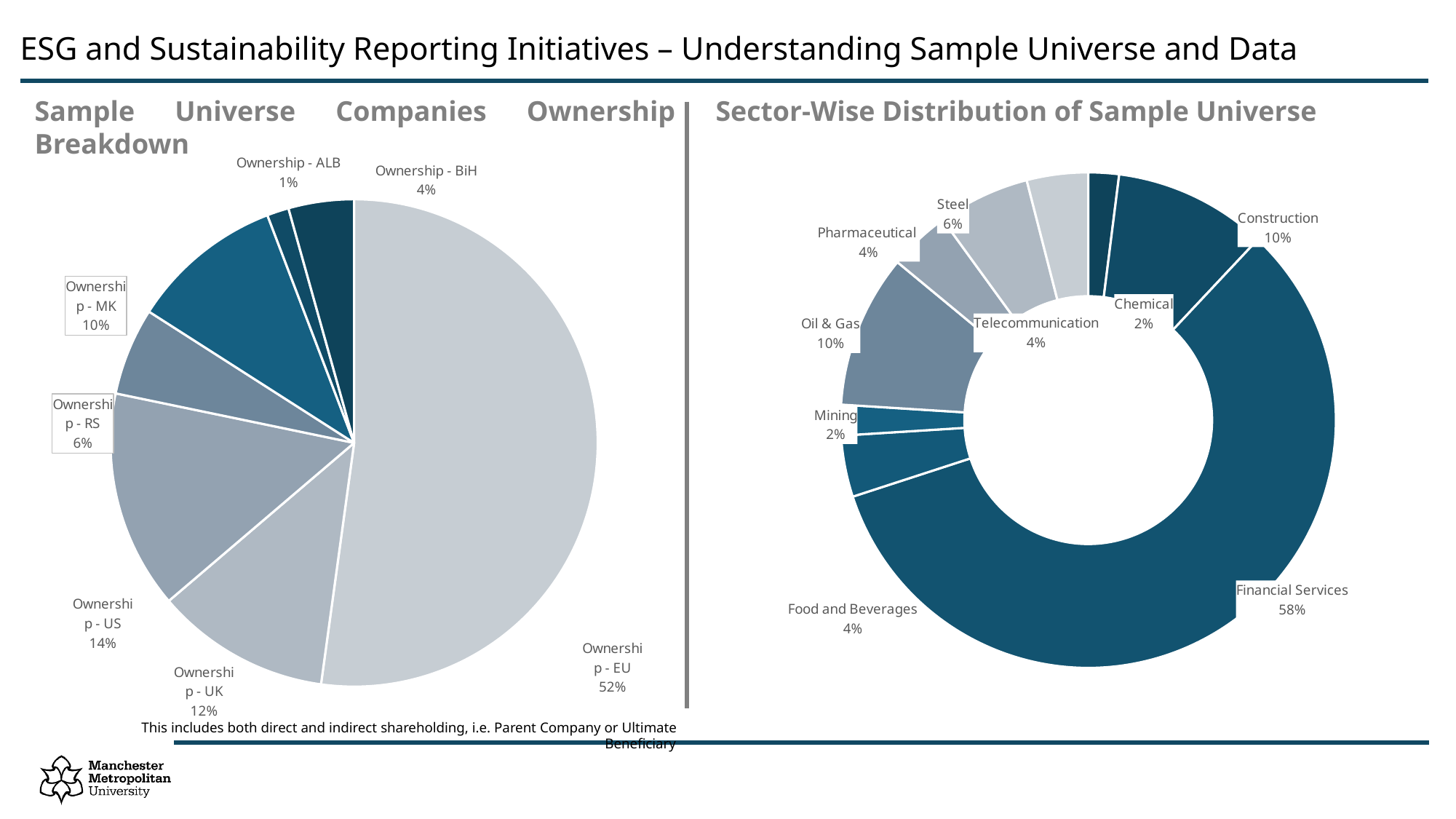
What kind of chart is the Sample Universe Companies Ownership Breakdown chart? Pie chart In the Sector-Wise Distribution of Sample Universe chart, how many sectors are shown? 9 In the Sample Universe Companies Ownership Breakdown chart, what share is Ownership - EU? 52% In the Sample Universe Companies Ownership Breakdown chart, which ownership category has the smallest share? Ownership - ALB In the Sample Universe Companies Ownership Breakdown chart, which ownership category has the largest share? Ownership - EU In the Sector-Wise Distribution of Sample Universe chart, which is larger, Oil & Gas or Pharmaceutical? Oil & Gas In the Sample Universe Companies Ownership Breakdown chart, what share is Ownership - US? 14% In the Sample Universe Companies Ownership Breakdown chart, which is larger, Ownership - MK or Ownership - BiH? Ownership - MK In the Sample Universe Companies Ownership Breakdown chart, what is the difference between Ownership - UK and Ownership - RS? 6% In the Sector-Wise Distribution of Sample Universe chart, what is the difference between Construction and Chemical? 8% In the Sector-Wise Distribution of Sample Universe chart, what share is Steel? 6% In the Sector-Wise Distribution of Sample Universe chart, what share is Financial Services? 58%